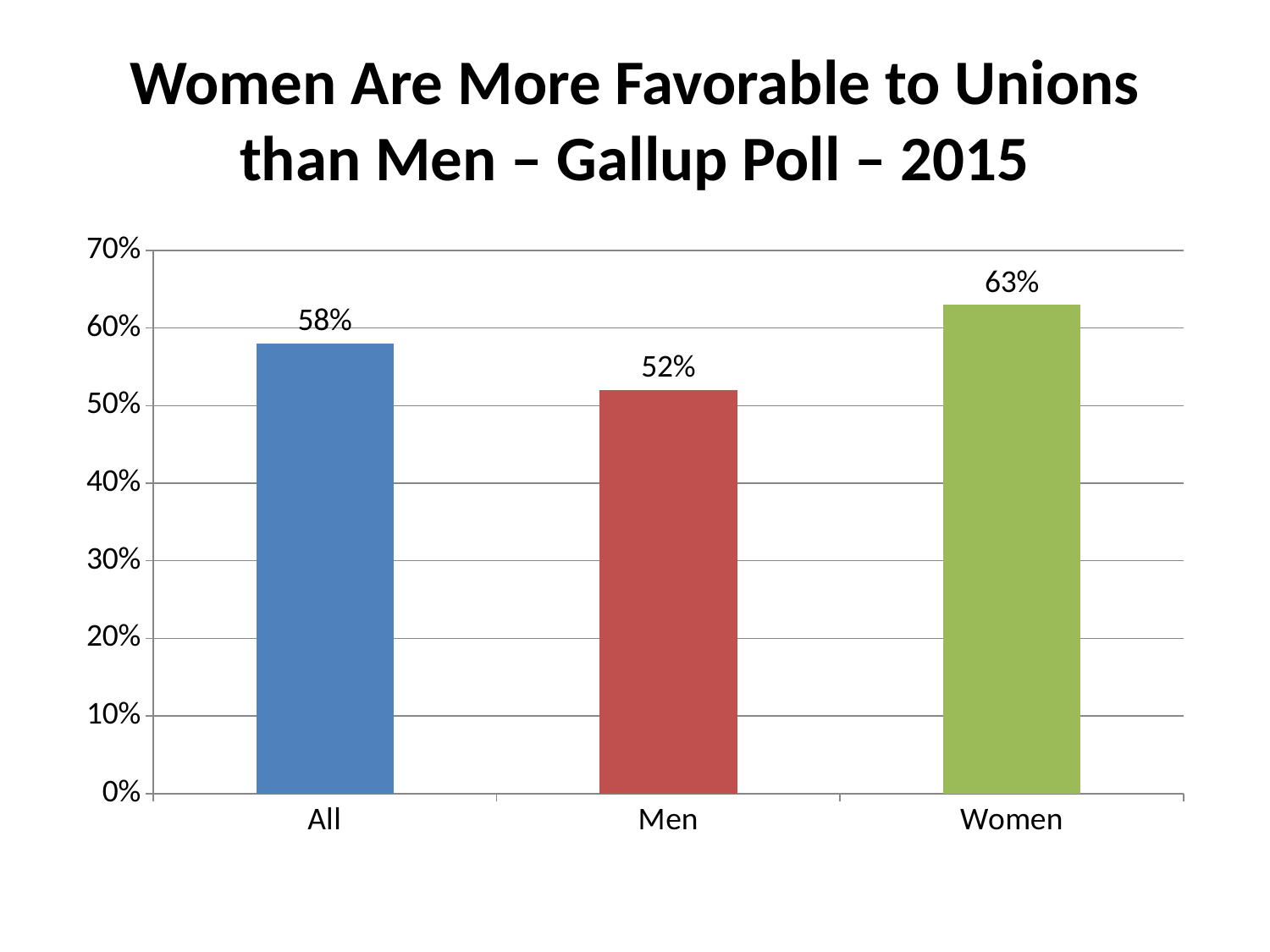
What is the difference between the values for All and Men? 6% What is the value for Men? 52% Which category has the lowest value? Men Which is larger, the value for All or the value for Men? All What colour is the bar for Women? green Is the value for Women greater or less than 60%? greater What is the difference between the values for Women and Men? 11% What is the value for All? 58% Which category has the highest value? Women What kind of chart is shown on the slide? bar chart How many categories are shown on the x axis? 3 What is the value for Women? 63%